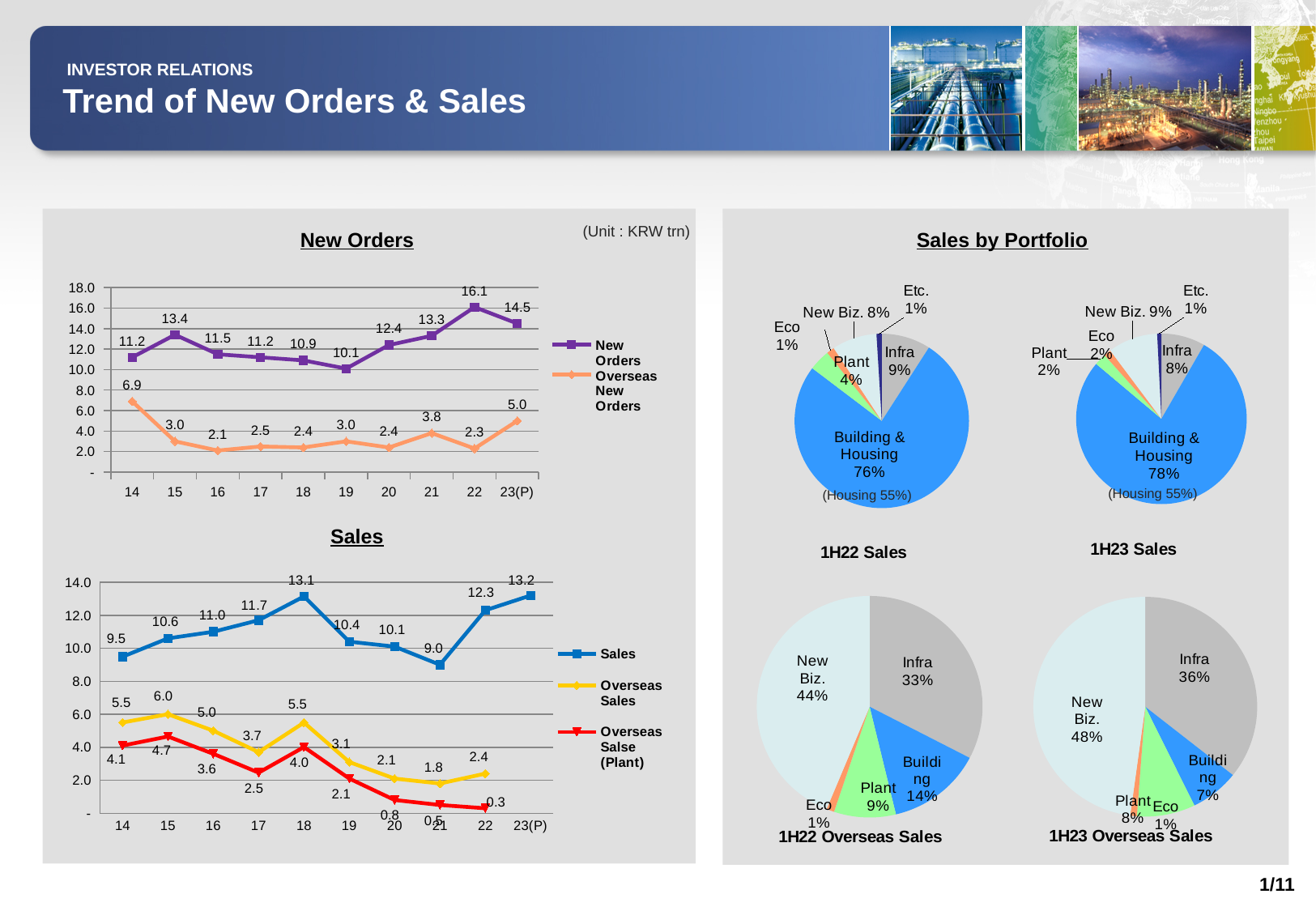
In the 1H23 Overseas Sales pie chart, which category has the largest share? New Biz. In the 1H22 Sales pie chart, what share does Building & Housing have? 76% In the New Orders chart, which year has the highest Overseas New Orders value? 14 In the Sales chart, is the Sales value for 18 larger than the Sales value for 19? Yes, 13.1 vs 10.4 In the New Orders chart, what is the difference between New Orders and Overseas New Orders in 23(P)? 9.5 In the New Orders chart, how many series does the legend list? 2 What kind of chart is the Sales chart? Line chart In the Sales chart, which year has the lowest Overseas Sales (Plant) value? 22 In the 1H22 Overseas Sales pie chart, what is the difference between the Infra share and the Building share? 19% In the Sales chart, what is the Sales value for 21? 9.0 In the 1H23 Sales pie chart, what share does New Biz. have? 9% In the New Orders chart, what is the New Orders value for 22? 16.1